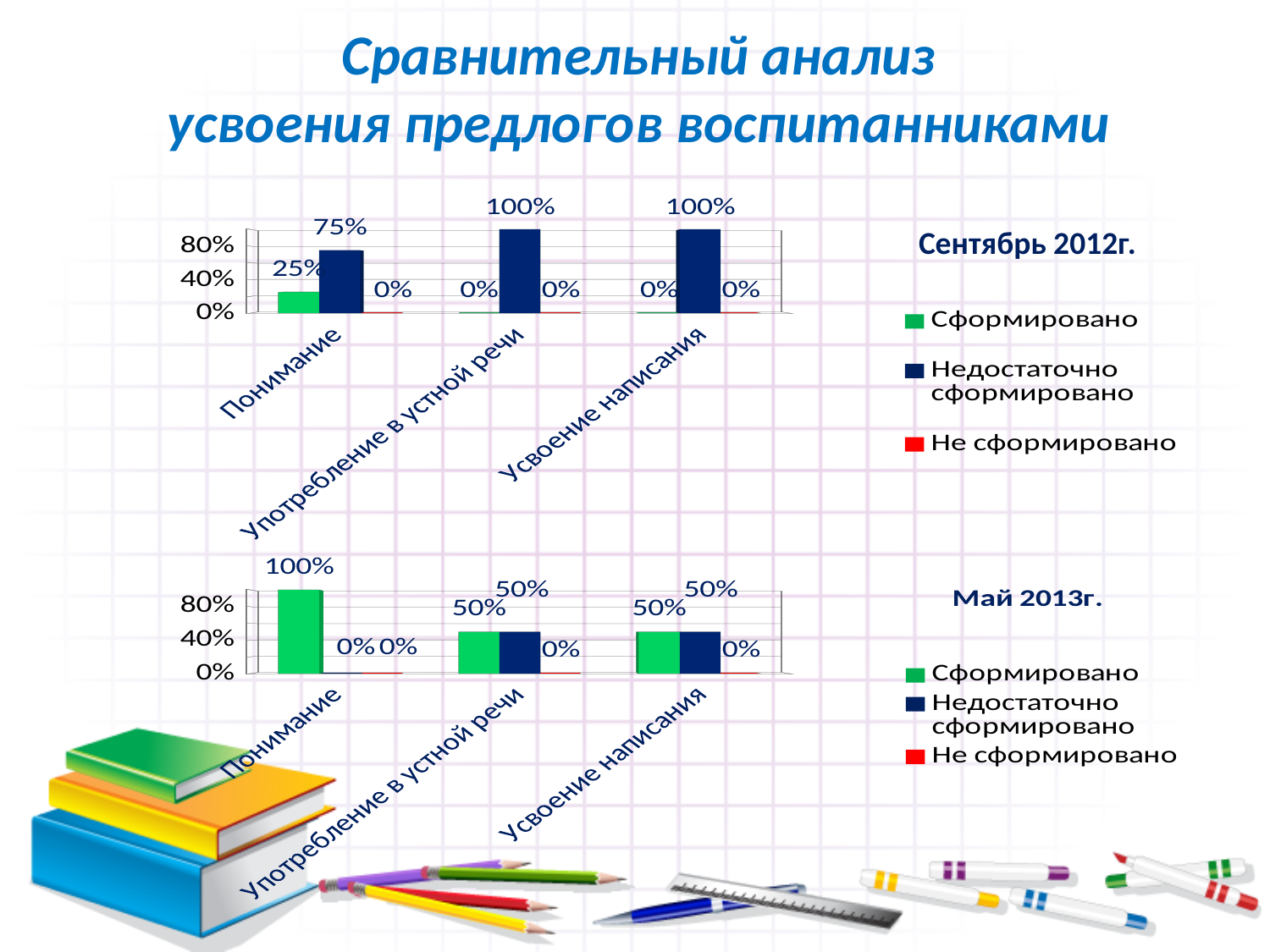
In the Май 2013г. chart, which is larger for Понимание: Сформировано or Недостаточно сформировано? Сформировано In the Май 2013г. chart, which category has the lowest Недостаточно сформировано value? Понимание In the Сентябрь 2012г. chart, which category has the highest Сформировано value? Понимание How many categories are shown on the x axis of the Сентябрь 2012г. chart? 3 In the Сентябрь 2012г. chart, what is the difference between Недостаточно сформировано and Сформировано for Понимание? 50% In the Май 2013г. chart, what is the value of Сформировано for Понимание? 100% What type of chart is the Сентябрь 2012г. chart? Bar chart In the Май 2013г. chart, what is the value of Недостаточно сформировано for Усвоение написания? 50% In the Сентябрь 2012г. chart, what is the value of Недостаточно сформировано for Употребление в устной речи? 100% How many series does the legend of the Май 2013г. chart list? 3 In the Сентябрь 2012г. chart, what is the value of Сформировано for Понимание? 25% In the Май 2013г. chart, what colour represents the Сформировано series? Green